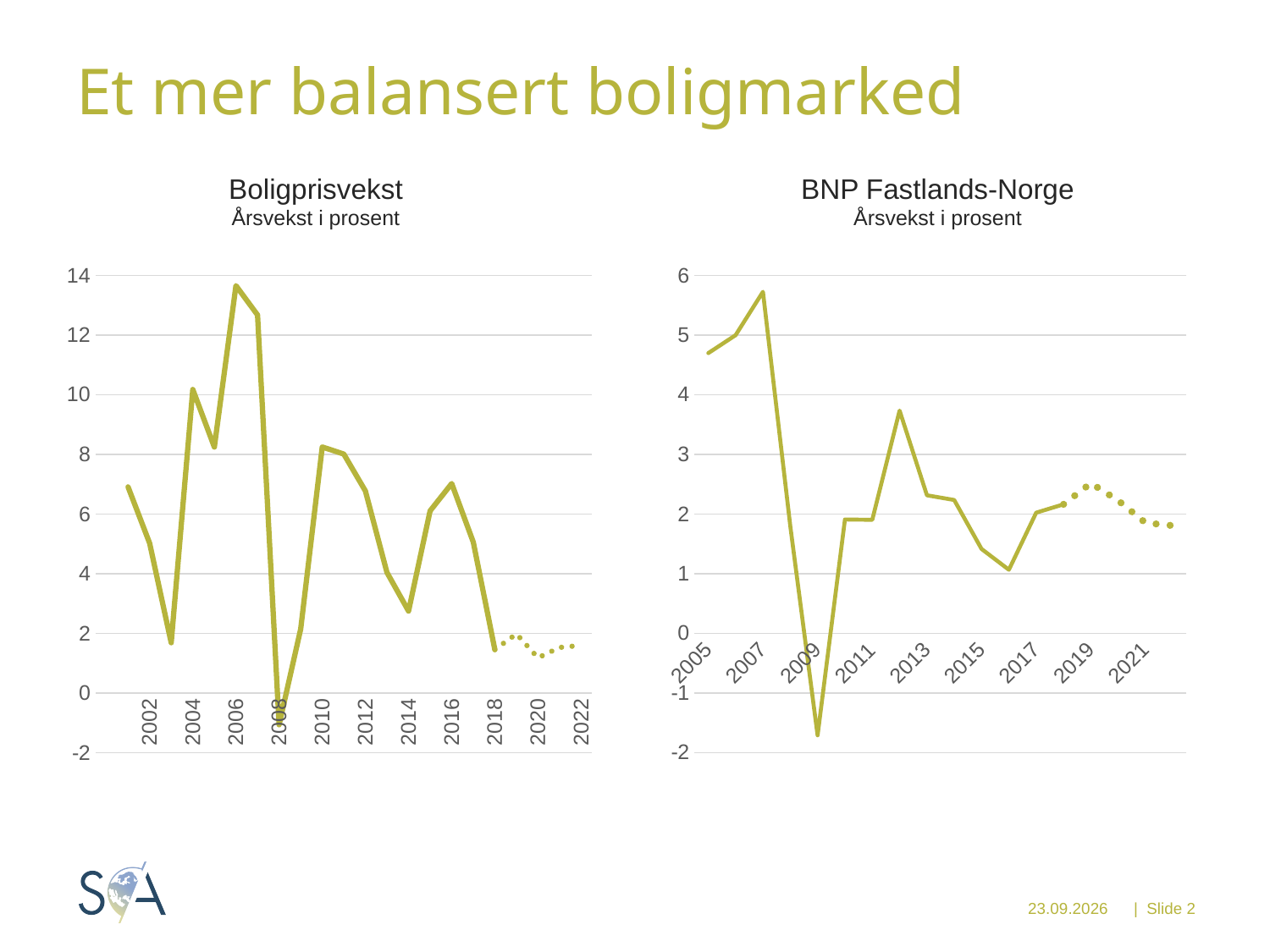
In the BNP Fastlands-Norge chart, is the value for 2013 greater or less than 3? less What kind of chart is the BNP Fastlands-Norge chart? line chart In the BNP Fastlands-Norge chart, does the line rise or fall from 2007 to 2009? fall In the BNP Fastlands-Norge chart, is the value for 2009 greater or less than 0? less In the Boligprisvekst chart, is the value for 2006 greater or less than 12? greater What subtitle appears under the title of the Boligprisvekst chart? Årsvekst i prosent What kind of chart is the Boligprisvekst chart? line chart In the BNP Fastlands-Norge chart, which year has the lowest value? 2009 In the BNP Fastlands-Norge chart, which year has the highest value? 2007 In the Boligprisvekst chart, which year has the highest value? 2006 In the Boligprisvekst chart, which year has the lowest value? 2008